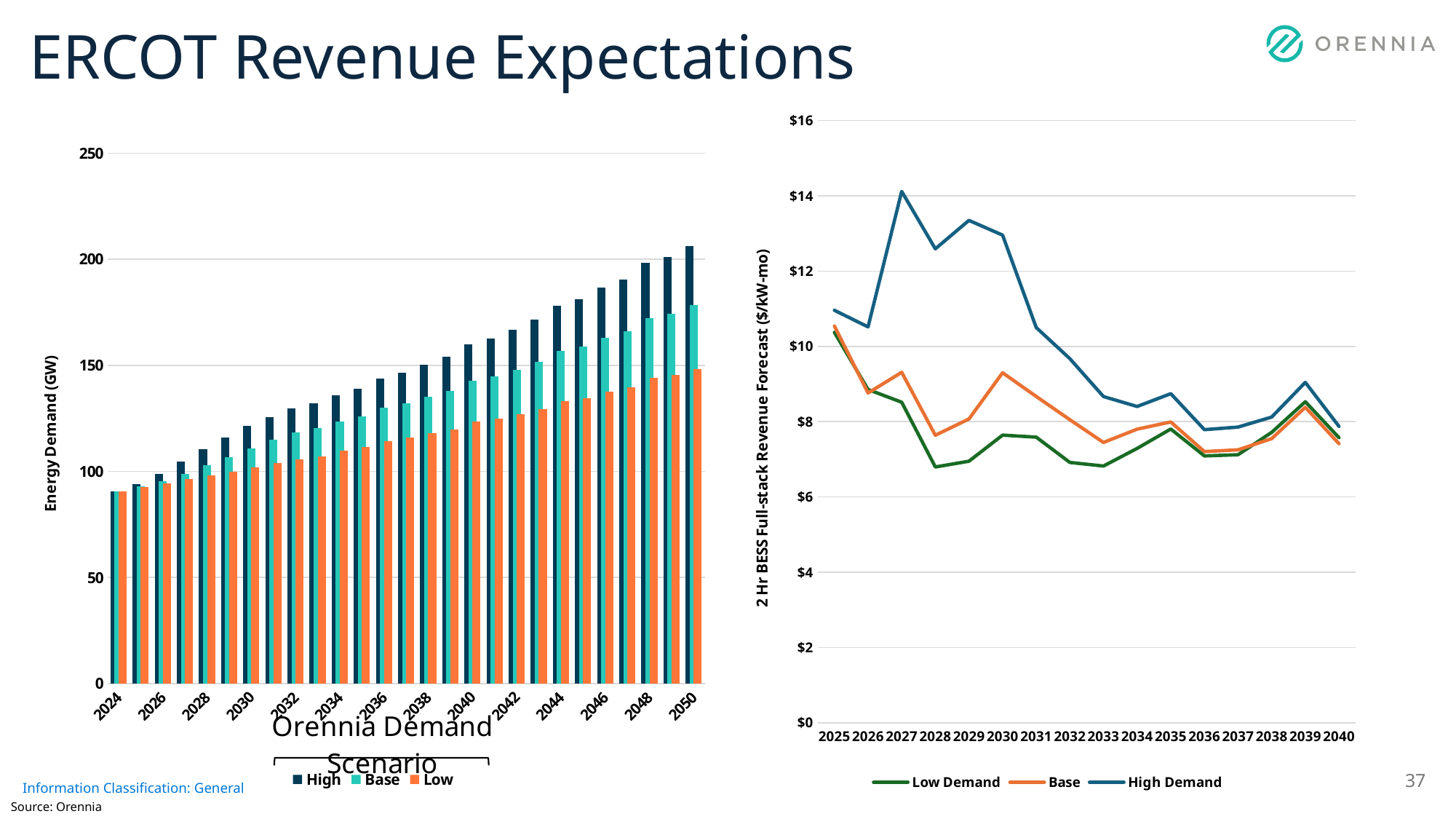
How many series does the legend of the right BESS revenue forecast chart list? 3 How many series does the legend of the left Energy Demand chart list? 3 In the left Energy Demand chart, do the High series values rise or fall from 2024 to 2050? rise What kind of chart is the right chart showing the 2 Hr BESS Full-stack Revenue Forecast? line chart In the left Energy Demand chart, is the Low value for 2024 greater or less than 100? less In the right BESS revenue forecast chart, in which year does the High Demand series reach its highest value? 2027 In the right BESS revenue forecast chart, is the High Demand value for 2027 greater or less than $12? greater In the right BESS revenue forecast chart, is the Low Demand value for 2028 greater or less than $8? less What kind of chart is the left chart showing Energy Demand (GW)? bar chart In the right BESS revenue forecast chart, which is larger in 2030, the Base value or the Low Demand value? Base How many years are plotted on the x axis of the right BESS revenue forecast chart? 16